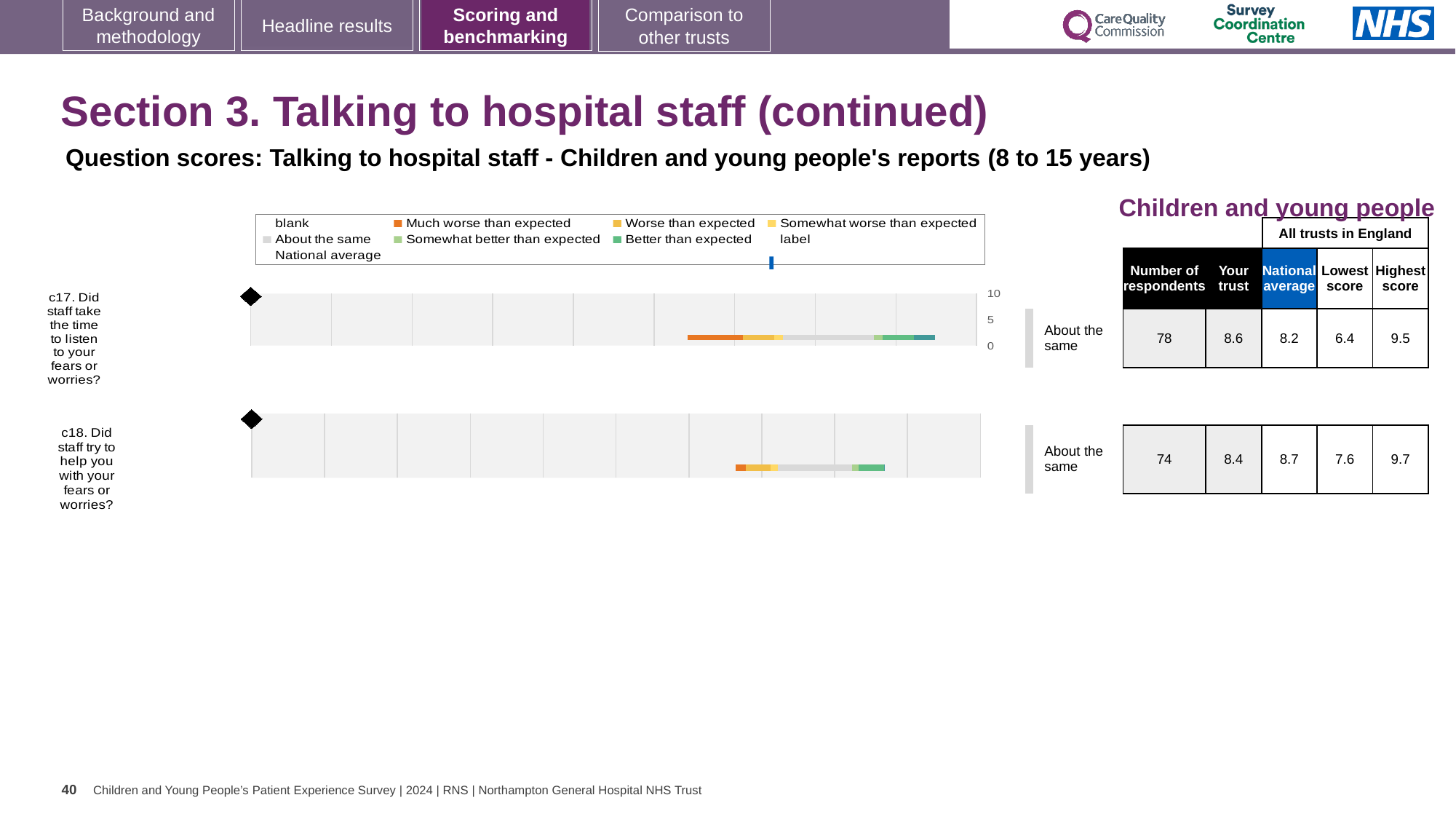
How many respondents answered question c17? 78 What kind of chart is used to show the benchmarking bands for each question? Bar chart What is the lowest score among all trusts in England for question c18? 7.6 How many survey questions are plotted on the slide's charts? 2 What is the national average score for question c18 (Did staff try to help you with your fears or worries?)? 8.7 Which question had more respondents, c17 or c18? c17 For question c17, how much higher is the trust's score than the national average? 0.4 What is the 'Your trust' score for question c17 (Did staff take the time to listen to your fears or worries?)? 8.6 What is the highest score among all trusts in England for question c17? 9.5 What benchmark category is shown for question c18? About the same For question c18, what is the difference between the highest score and the lowest score across all trusts in England? 2.1 For question c17, which is higher: the trust's score or the national average? Your trust (8.6)